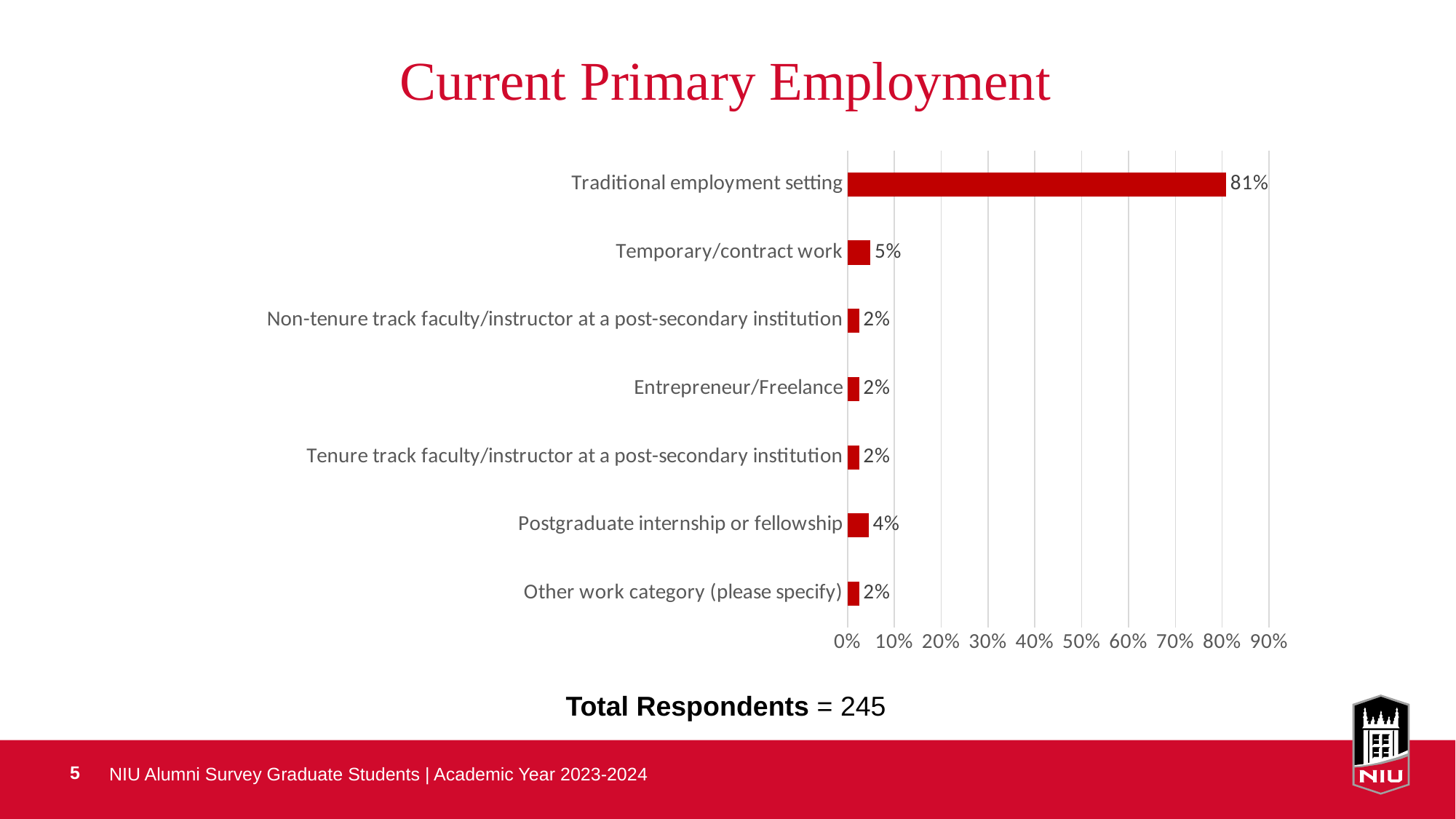
What percentage of respondents are in a traditional employment setting? 81% What is the value for Postgraduate internship or fellowship? 4% Which category has the highest value? Traditional employment setting Is the value for Traditional employment setting greater or less than 80%? greater What is the value for Entrepreneur/Freelance? 2% What is the total number of respondents stated on the slide? 245 Which is larger, Temporary/contract work or Postgraduate internship or fellowship? Temporary/contract work What kind of chart is shown on the slide? Bar chart What is the value for Temporary/contract work? 5% What is the difference between Traditional employment setting and Temporary/contract work? 76% How many categories are shown in the chart? 7 What is the difference between Temporary/contract work and Postgraduate internship or fellowship? 1%